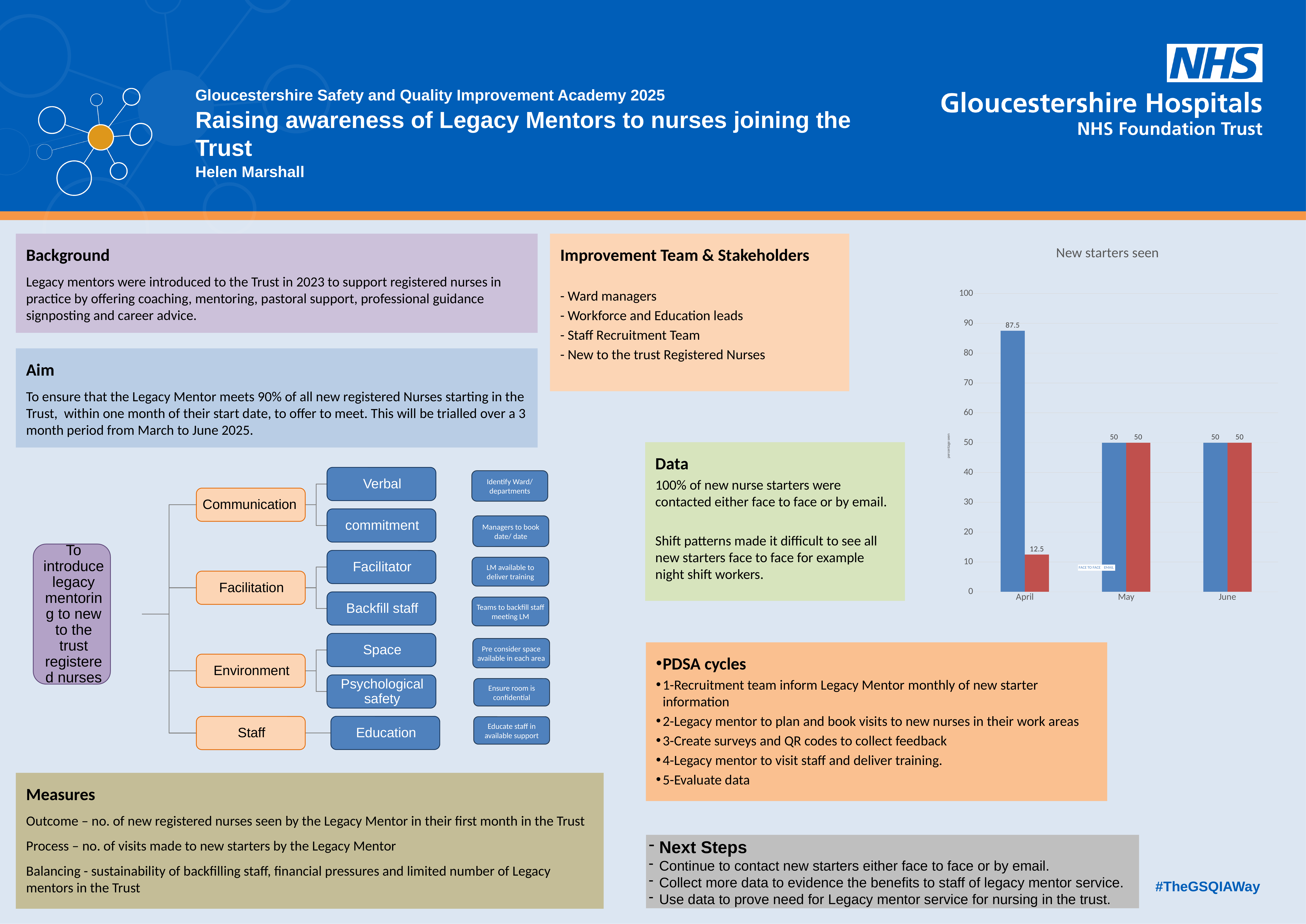
In the 'New starters seen' chart, what is the difference between the face to face and email values for April? 75 In the 'New starters seen' chart, which is larger for April: the face to face value or the email value? face to face In the 'New starters seen' chart, which month has the lowest email value? April In the 'New starters seen' chart, what is the value of the red (email) bar for April? 12.5 In the 'New starters seen' chart, what is the value of the email bar for June? 50 In the 'New starters seen' chart, which month has the highest face to face value? April How many months are shown on the x axis of the 'New starters seen' chart? 3 In the 'New starters seen' chart, what is the value of the blue (face to face) bar for April? 87.5 What type of chart is 'New starters seen'? bar chart In the 'New starters seen' chart, is the face to face value for April greater or less than 80? greater In the 'New starters seen' chart, what is the value of the face to face bar for May? 50 How many series does the 'New starters seen' chart plot? 2